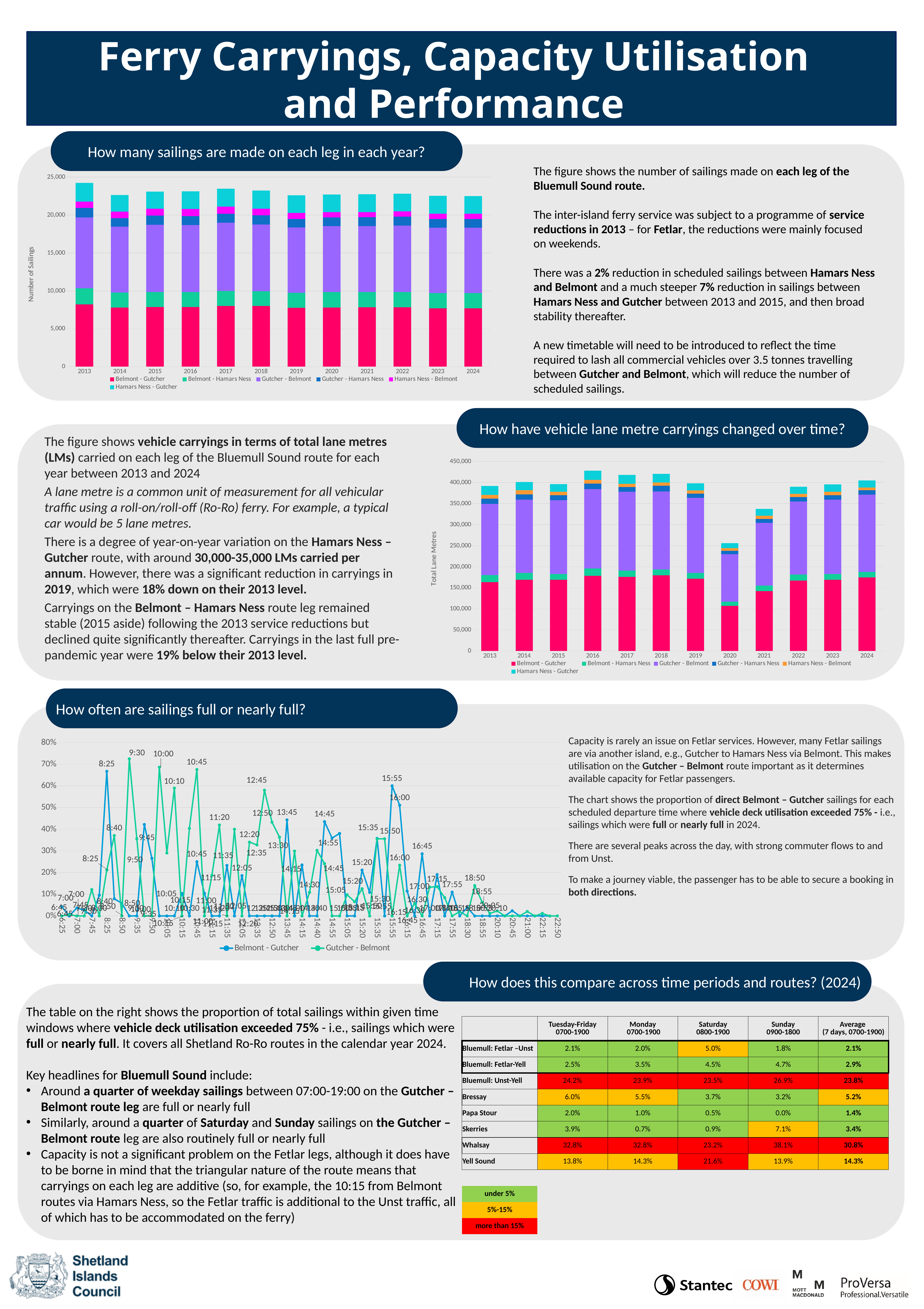
In the chart titled 'How many sailings are made on each leg in each year?', what is the label on the vertical axis? Number of Sailings In the chart titled 'How have vehicle lane metre carryings changed over time?', is the total for 2020 greater or less than 300,000? less In the chart titled 'How often are sailings full or nearly full?', at which departure time does the Gutcher - Belmont series reach its highest value? 9:30 In the chart titled 'How have vehicle lane metre carryings changed over time?', which year has the lowest total lane metres? 2020 In the chart titled 'How have vehicle lane metre carryings changed over time?', how many series does the legend list? 6 In the chart titled 'How often are sailings full or nearly full?', what kind of chart is used? line chart In the chart titled 'How many sailings are made on each leg in each year?', how many years are shown on the x axis? 12 In the chart titled 'How many sailings are made on each leg in each year?', what kind of chart is used? bar chart In the chart titled 'How many sailings are made on each leg in each year?', which year has the highest total number of sailings? 2013 In the chart titled 'How many sailings are made on each leg in each year?', how many series does the legend list? 6 In the chart titled 'How have vehicle lane metre carryings changed over time?', which year has the larger total lane metres, 2020 or 2021? 2021 In the chart titled 'How many sailings are made on each leg in each year?', is the total number of sailings in 2013 greater or less than 20,000? greater